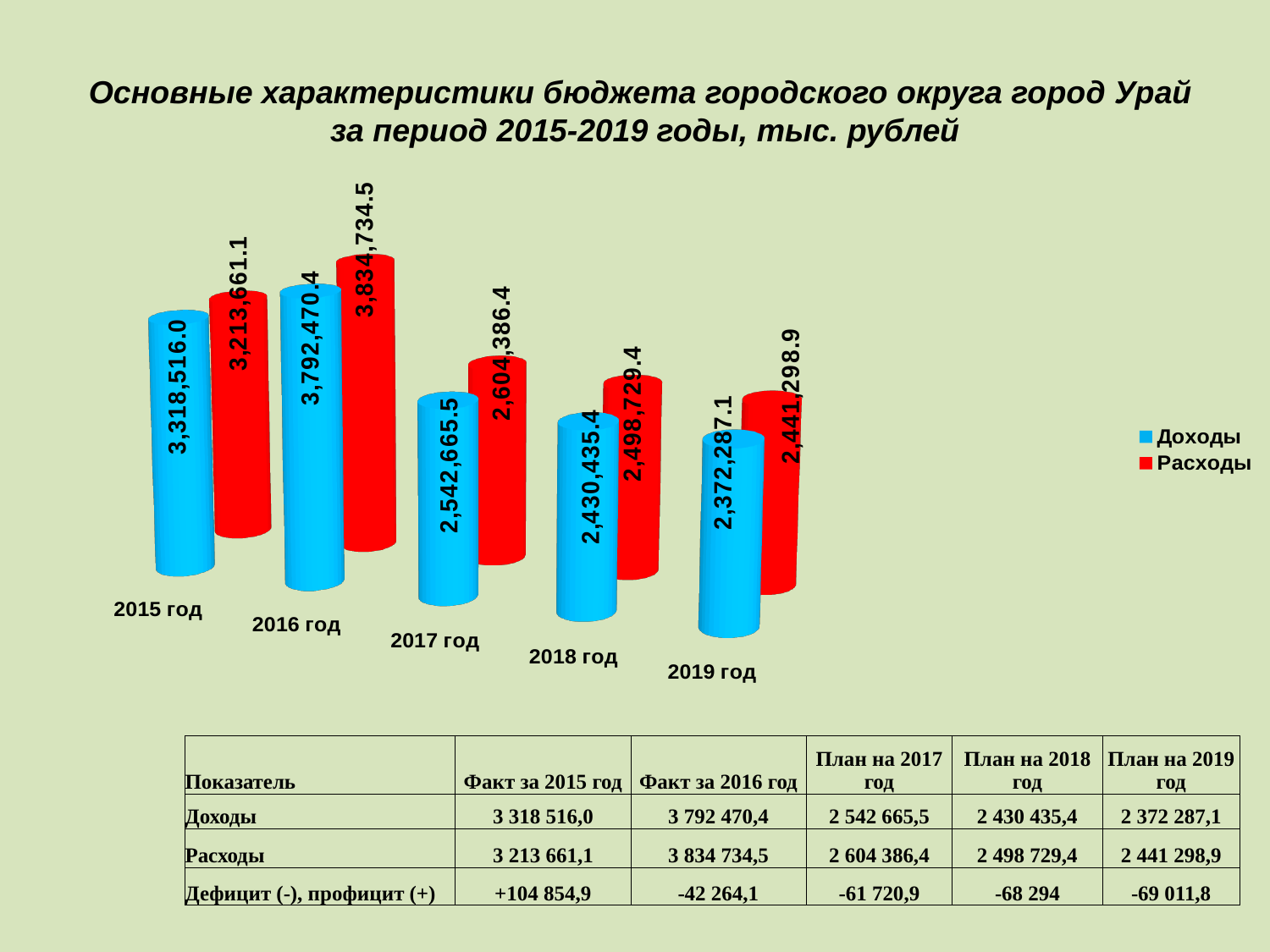
How many series does the legend list? 2 What is the value of Расходы for 2019 год? 2,441,298.9 What is the value of Расходы for 2017 год? 2,604,386.4 In which year is Доходы highest? 2016 год What kind of chart is shown on the slide? bar chart What is the value of Доходы for 2016 год? 3,792,470.4 In which year is Расходы lowest? 2019 год What is the difference between Доходы and Расходы for 2015 год? 104,854.9 Do the Доходы values rise or fall from 2016 год to 2019 год? fall How many years are shown on the x axis of the chart? 5 For 2018 год, which is larger, Доходы or Расходы? Расходы What is the difference between Расходы and Доходы for 2016 год? 42,264.1